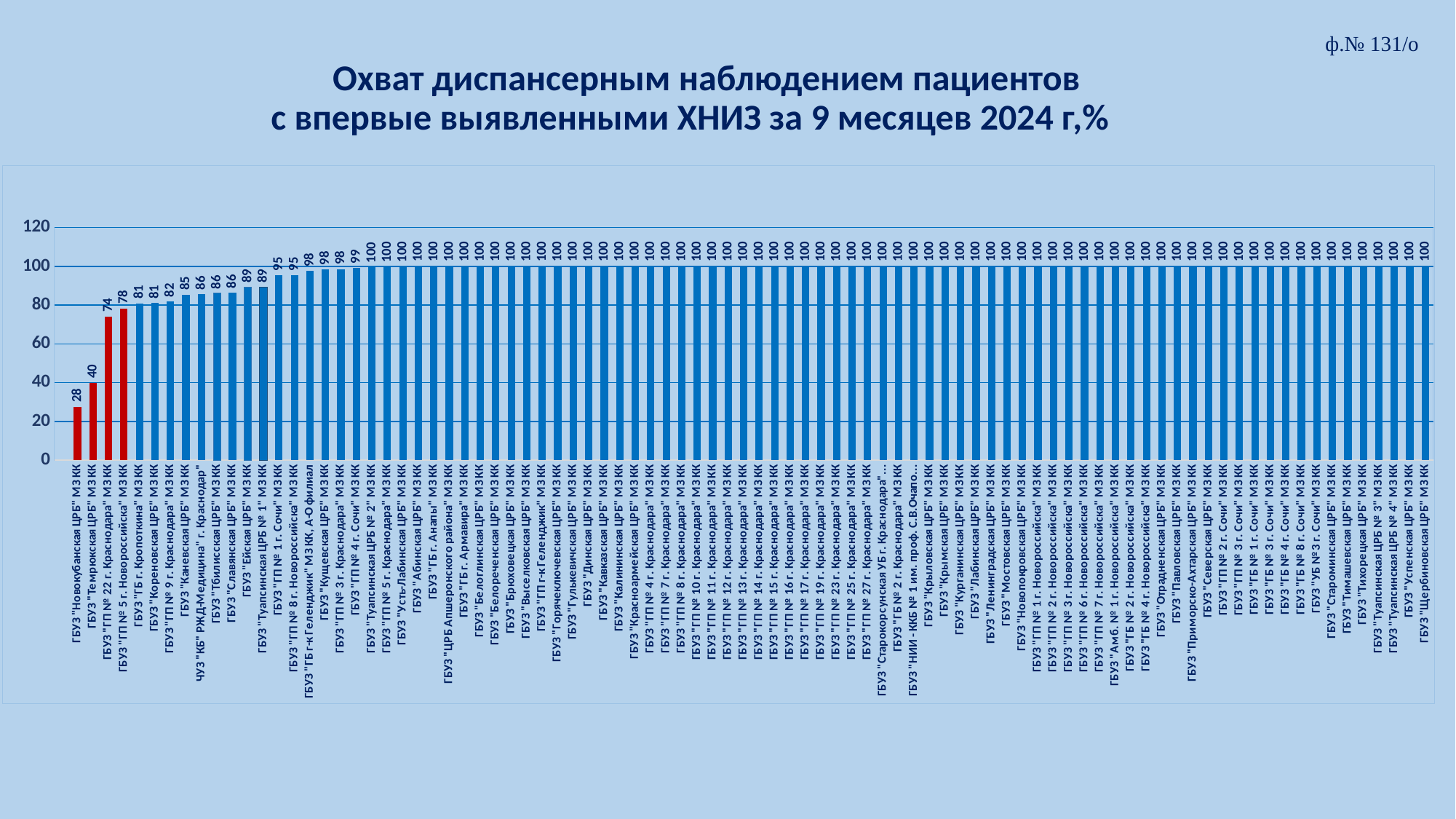
What kind of chart is shown on the slide? bar chart What is the difference between the values for ГБУЗ "Темрюкская ЦРБ" МЗ КК and ГБУЗ "Новокубанская ЦРБ" МЗ КК? 12 What is the value for ГБУЗ "ГП № 5 г. Новороссийска" МЗ КК? 78 How many bars are coloured red on the chart? 4 What is the value for ГБУЗ "Темрюкская ЦРБ" МЗ КК? 40 Is the value for ГБУЗ "Новокубанская ЦРБ" МЗ КК greater or less than 40? less What is the value for ГБУЗ "Новокубанская ЦРБ" МЗ КК? 28 Which has a larger value, ГБУЗ "Каневская ЦРБ" МЗ КК or ГБУЗ "Ейская ЦРБ" МЗ КК? ГБУЗ "Ейская ЦРБ" МЗ КК Do the values rise or fall from left to right along the x axis? rise Which institution has the lowest value on the chart? ГБУЗ "Новокубанская ЦРБ" МЗ КК What is the value for ГБУЗ "ГП № 22 г. Краснодара" МЗ КК? 74 What is the value for ГБУЗ "ГП № 4 г. Сочи" МЗ КК? 99